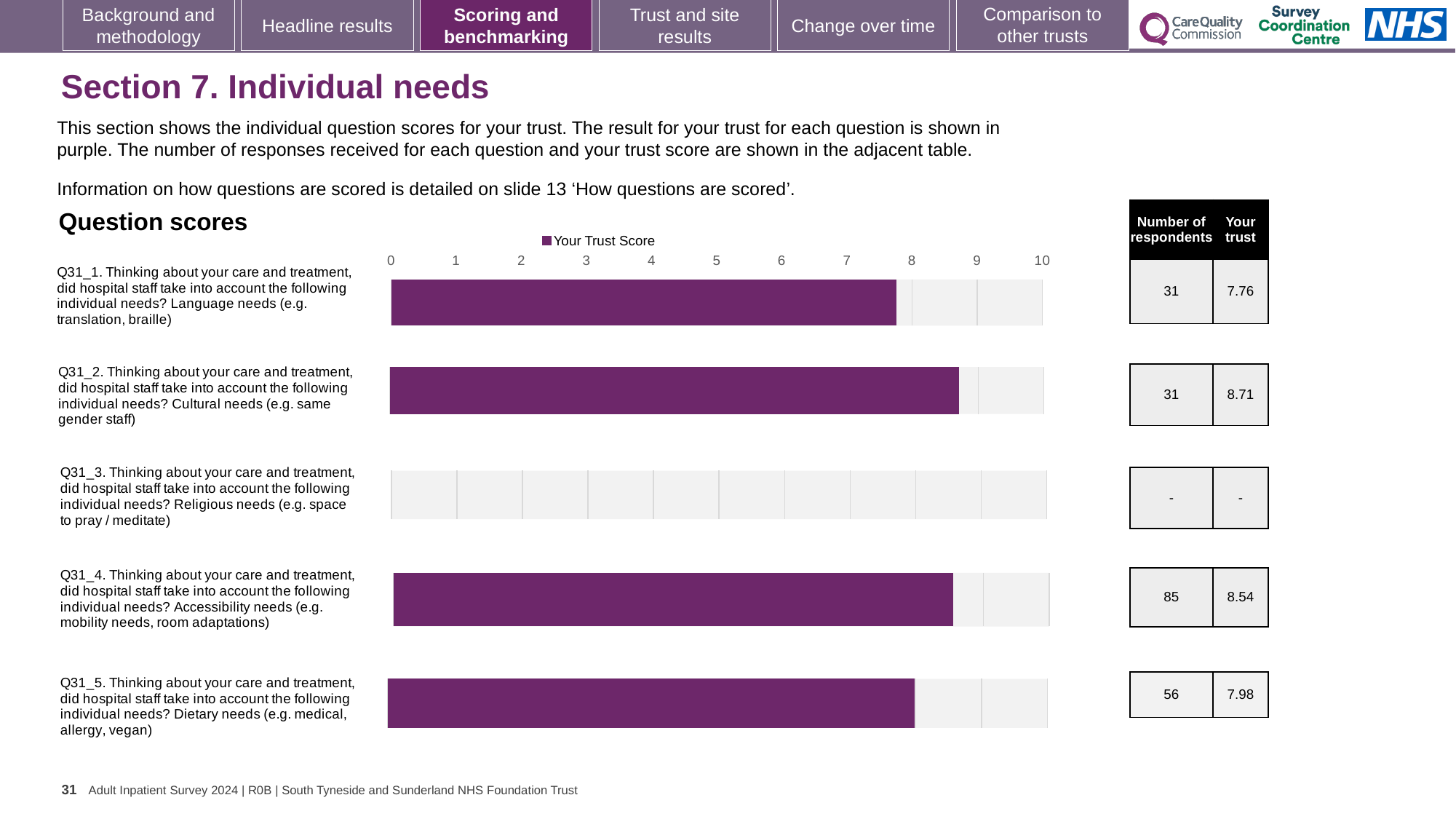
How many series does the chart legend list? 1 Which question has the highest trust score among those with a plotted bar? Q31_2 (Cultural needs) What is the trust score for Q31_2 (Cultural needs)? 8.71 Is the trust score bar for Q31_1 (Language needs) greater or less than 8? less Which question has the lowest trust score among those with a plotted bar? Q31_1 (Language needs) Which has the larger trust score, Q31_4 (Accessibility needs) or Q31_5 (Dietary needs)? Q31_4 (Accessibility needs) What is the trust score for Q31_5 (Dietary needs)? 7.98 What is the difference between the trust scores for Q31_2 (Cultural needs) and Q31_1 (Language needs)? 0.95 What is the trust score for Q31_1 (Language needs)? 7.76 What is the trust score for Q31_4 (Accessibility needs)? 8.54 What kind of chart is used to show the question scores? Bar chart What is the name of the series shown in the chart legend? Your Trust Score